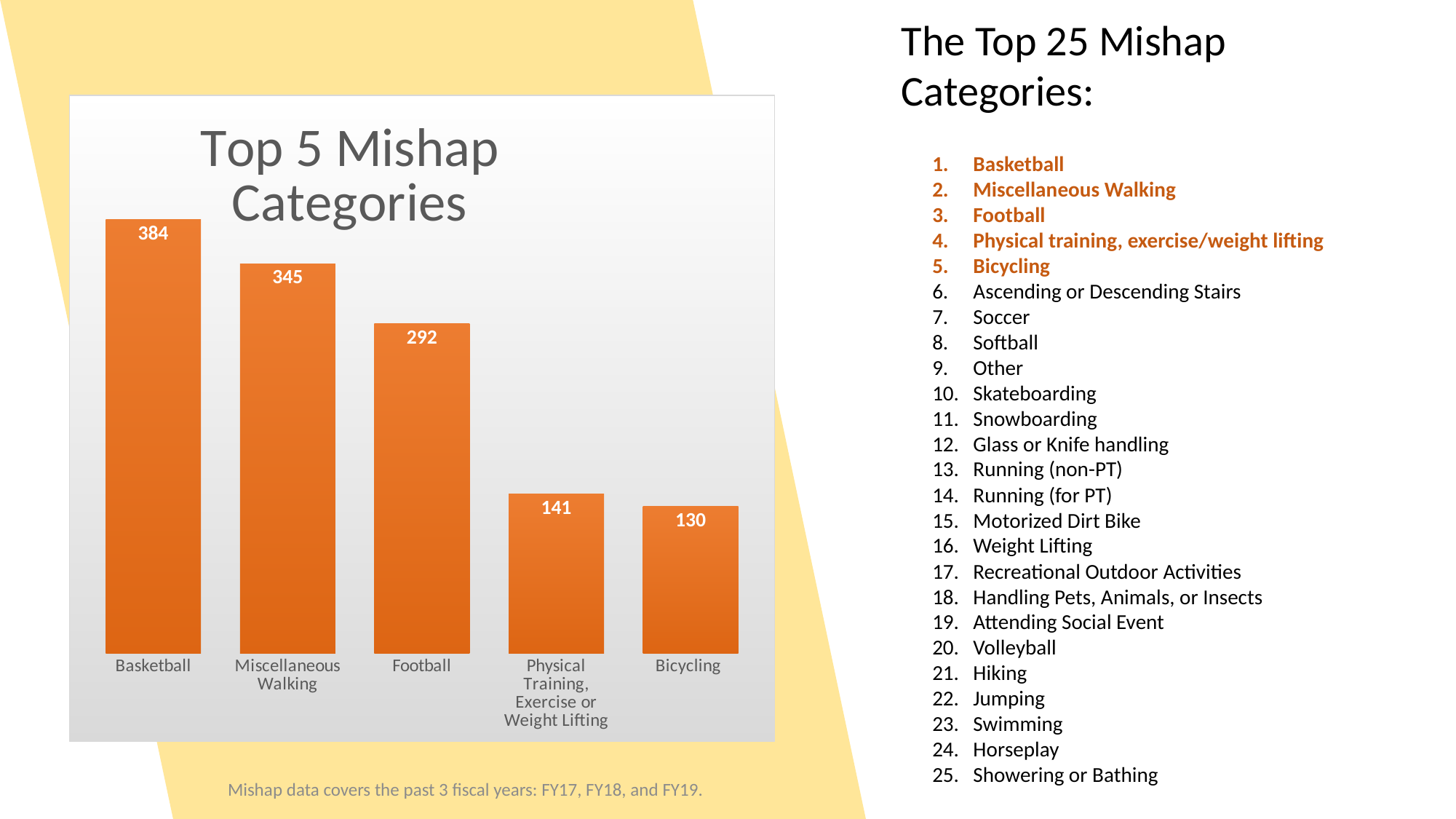
What kind of chart is shown? Bar chart Which is larger, the value for Miscellaneous Walking or the value for Football? Miscellaneous Walking What is the value for Football? 292 How many categories are shown in the chart? 5 What is the value for Miscellaneous Walking? 345 Which category has the lowest value? Bicycling What is the title of the chart? Top 5 Mishap Categories What is the value for Bicycling? 130 Which category has the highest value? Basketball What is the difference between the values for Basketball and Football? 92 What is the value for Basketball? 384 What is the value for Physical Training, Exercise or Weight Lifting? 141